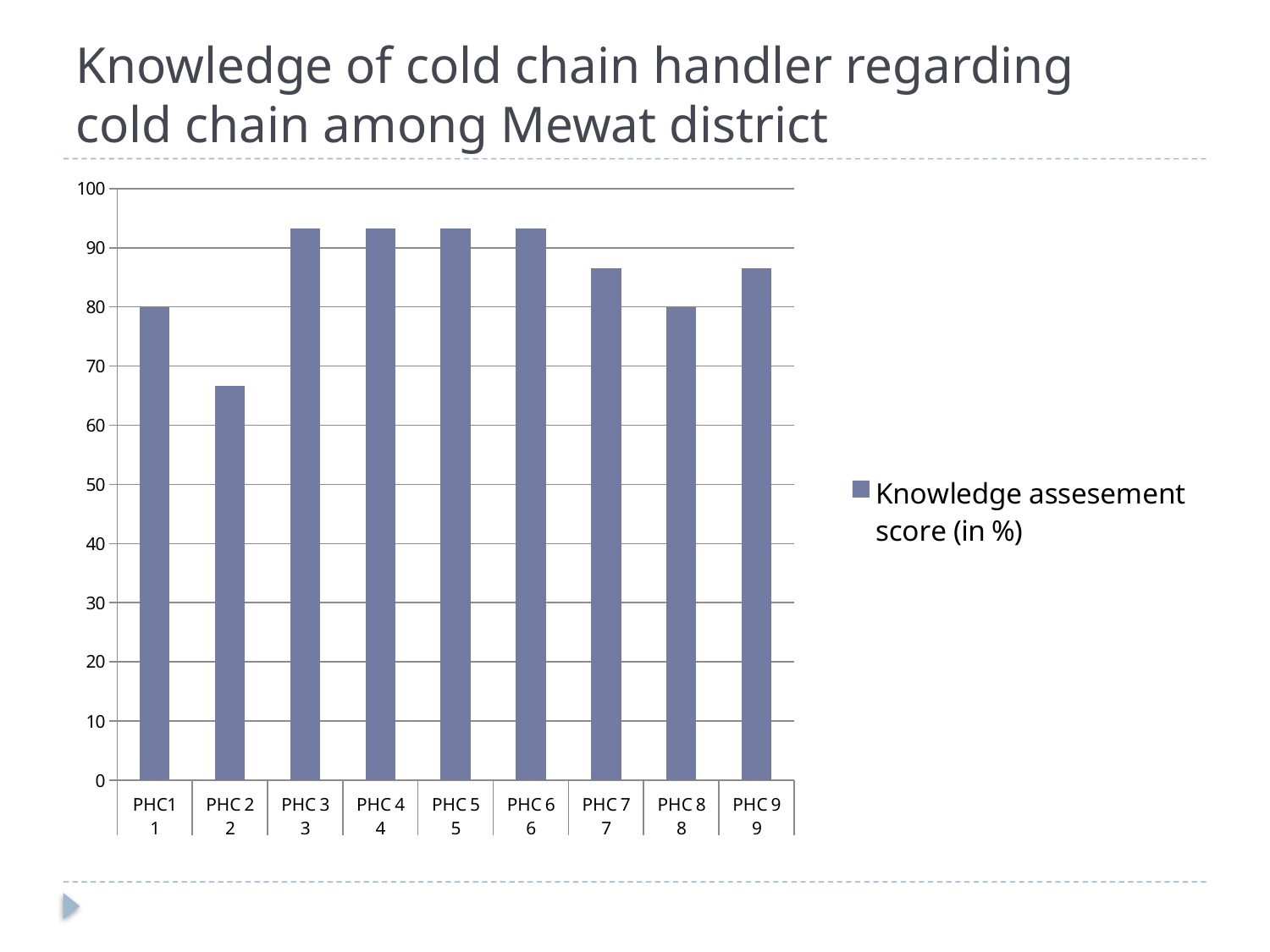
Is the knowledge assessment score for PHC 7 greater or less than 90? less Which has a higher knowledge assessment score, PHC 7 or PHC 8? PHC 7 Is the knowledge assessment score for PHC 3 greater or less than 90? greater What is the knowledge assessment score for PHC1? 80 Which PHC has the lowest knowledge assessment score? PHC 2 What series name is shown in the legend? Knowledge assesement score (in %) What kind of chart is shown on the slide? bar chart Which has a higher knowledge assessment score, PHC 2 or PHC 3? PHC 3 How many series does the legend list? 1 Is the knowledge assessment score for PHC 9 greater or less than 80? greater How many PHC categories are plotted on the x axis? 9